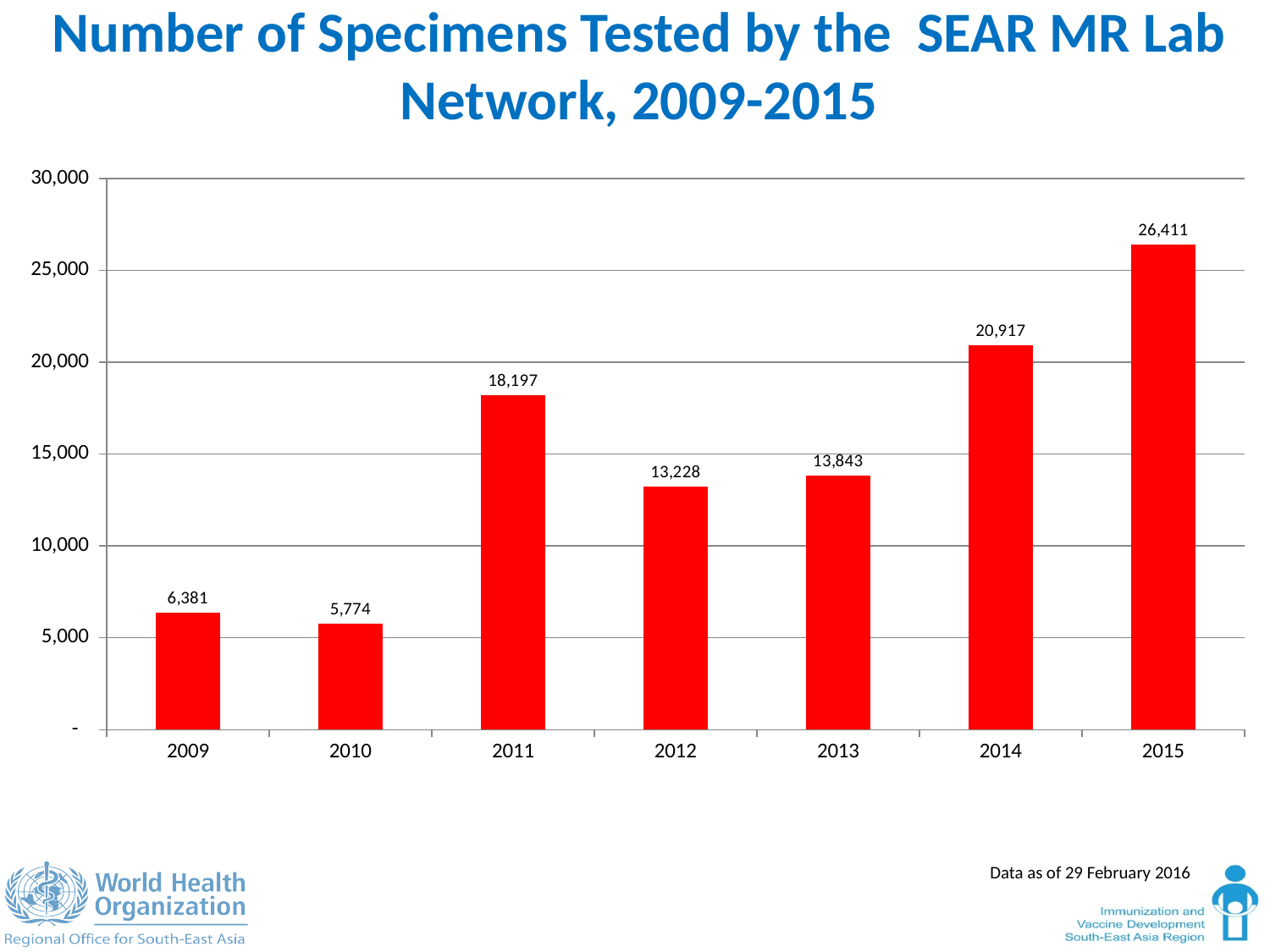
What kind of chart is shown on the slide? Bar chart Which year has the lowest number of specimens tested? 2010 Which year has the highest number of specimens tested? 2015 What is the value shown for 2014? 20,917 How many years are shown on the x axis? 7 What is the difference between the values for 2009 and 2010? 607 How many specimens were tested in 2011? 18,197 Is the value for 2013 greater or less than 15,000? less Did the number of specimens tested rise or fall from 2013 to 2015? Rise What is the title of the chart? Number of Specimens Tested by the SEAR MR Lab Network, 2009-2015 What is the difference between the number of specimens tested in 2015 and in 2014? 5,494 Which year had more specimens tested, 2011 or 2012? 2011